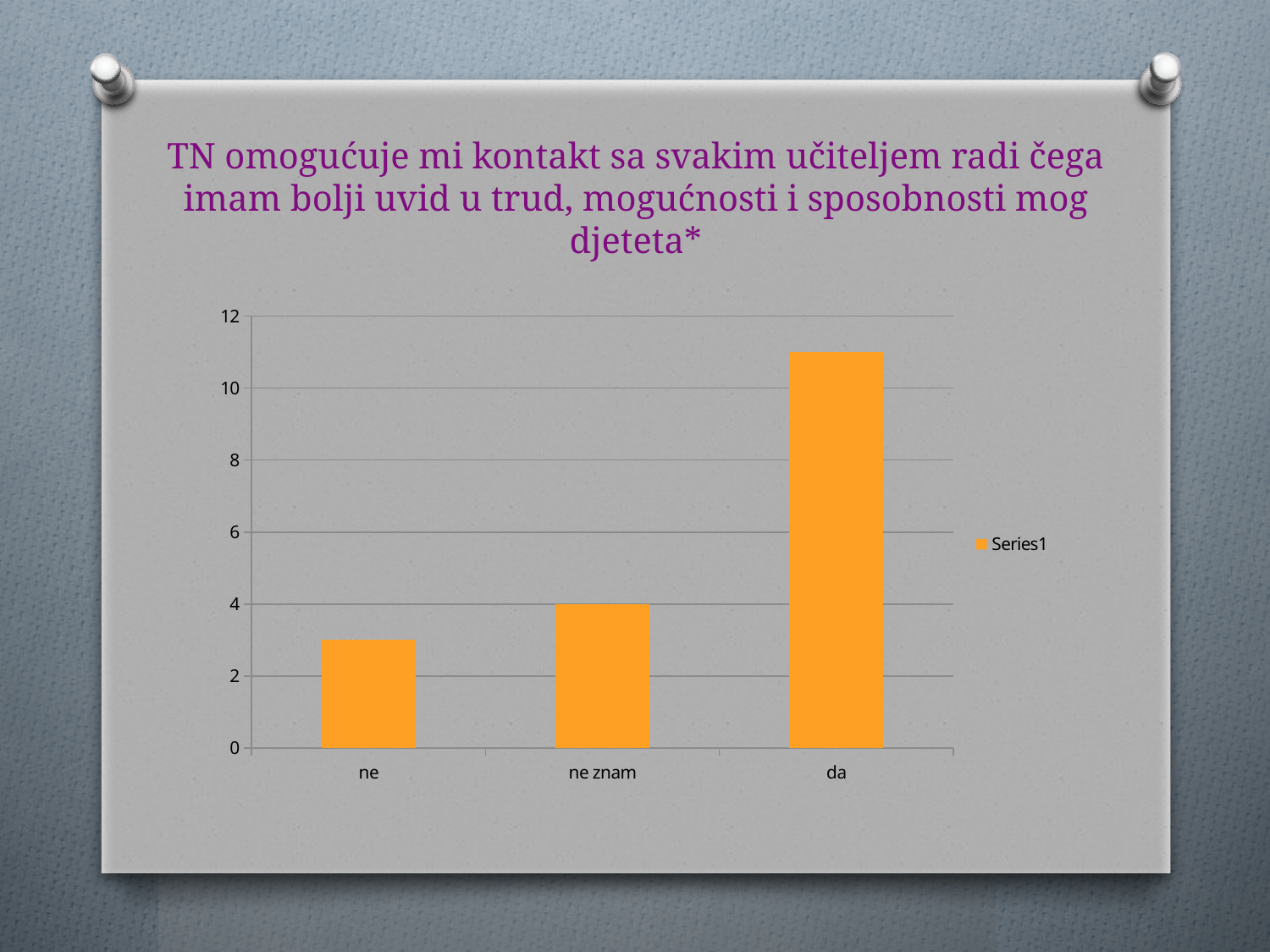
Which category has the highest value? da How many categories are shown on the x axis? 3 Do the values rise or fall from left to right along the x axis? rise Is the value for "ne" greater or less than 2? greater What kind of chart is shown on the slide? bar chart Is the value for "da" greater or less than 10? greater What is the name of the series shown in the legend? Series1 How many series does the legend list? 1 Which is larger, the value for "da" or the value for "ne znam"? da What is the value for "ne znam"? 4 Is the value for "ne" greater or less than 4? less Which category has the lowest value? ne